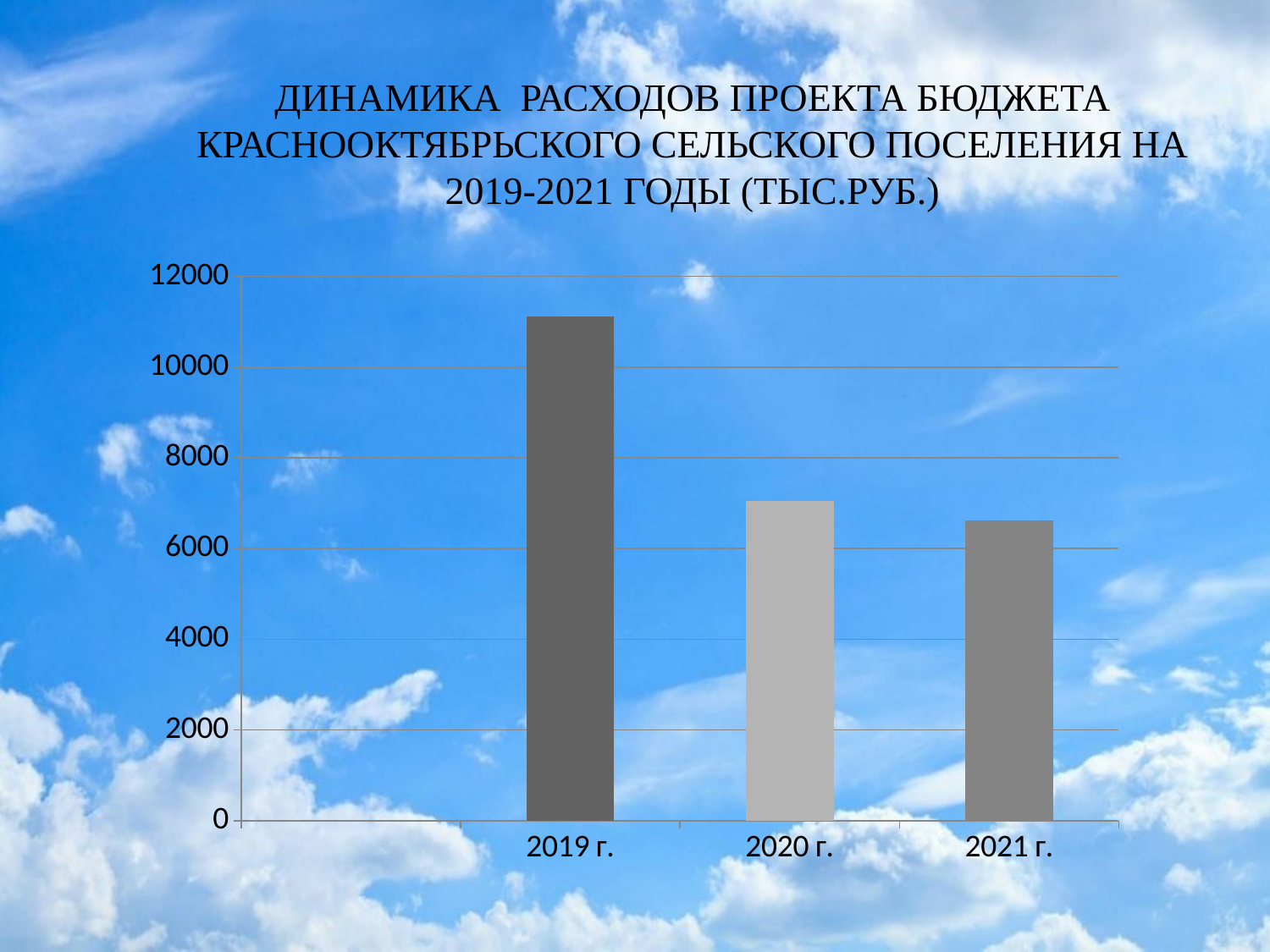
Which year has the highest value on the chart? 2019 г. Is the value for 2020 г. greater or less than 8000? less Which is larger, the value for 2019 г. or the value for 2020 г.? 2019 г. How many categories (years) are plotted on the chart? 3 What is the maximum value shown on the vertical axis of the chart? 12000 Is the value for 2021 г. greater or less than 6000? greater Is the value for 2019 г. greater or less than 10000? greater Which year has the lowest value on the chart? 2021 г. What kind of chart is shown on the slide? bar chart Which is larger, the value for 2020 г. or the value for 2021 г.? 2020 г. Do the values rise or fall from 2019 г. to 2021 г.? fall